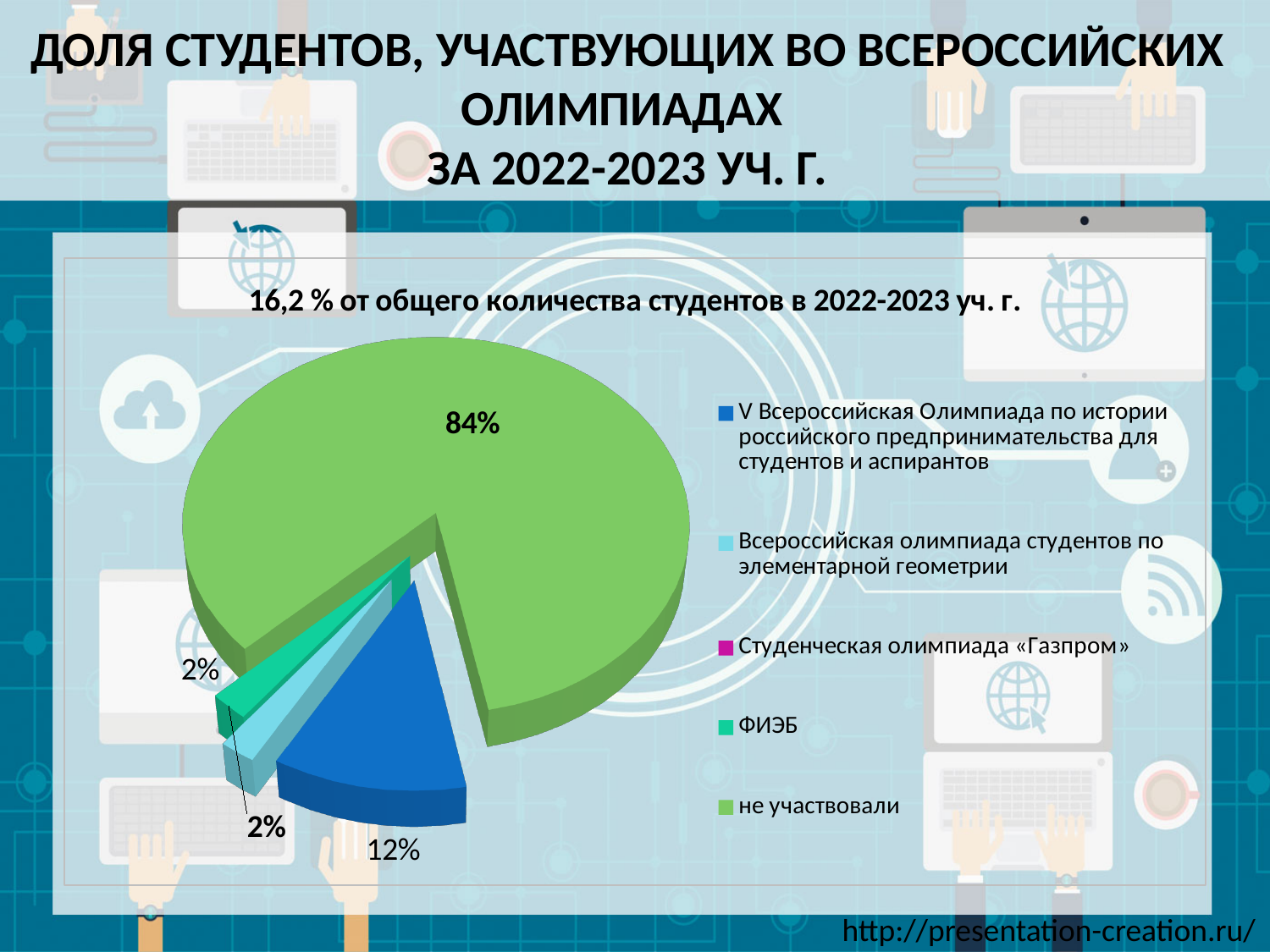
What share of the pie is labelled for "Всероссийская олимпиада студентов по элементарной геометрии"? 2% What is the title printed above the pie chart? 16,2 % от общего количества студентов в 2022-2023 уч. г. What colour is the "не участвовали" slice of the pie? green How many entries does the chart's legend list? 5 Which is larger: the share for "ФИЭБ" or the share for "V Всероссийская Олимпиада по истории российского предпринимательства для студентов и аспирантов"? V Всероссийская Олимпиада по истории российского предпринимательства для студентов и аспирантов What kind of chart is shown on the slide? pie chart What share of the pie is labelled for "не участвовали"? 84% What is the difference in percentage points between the "не участвовали" slice and the "V Всероссийская Олимпиада по истории российского предпринимательства" slice? 72 What share of the pie is labelled for "V Всероссийская Олимпиада по истории российского предпринимательства для студентов и аспирантов"? 12% Which category has the largest share of the pie? не участвовали